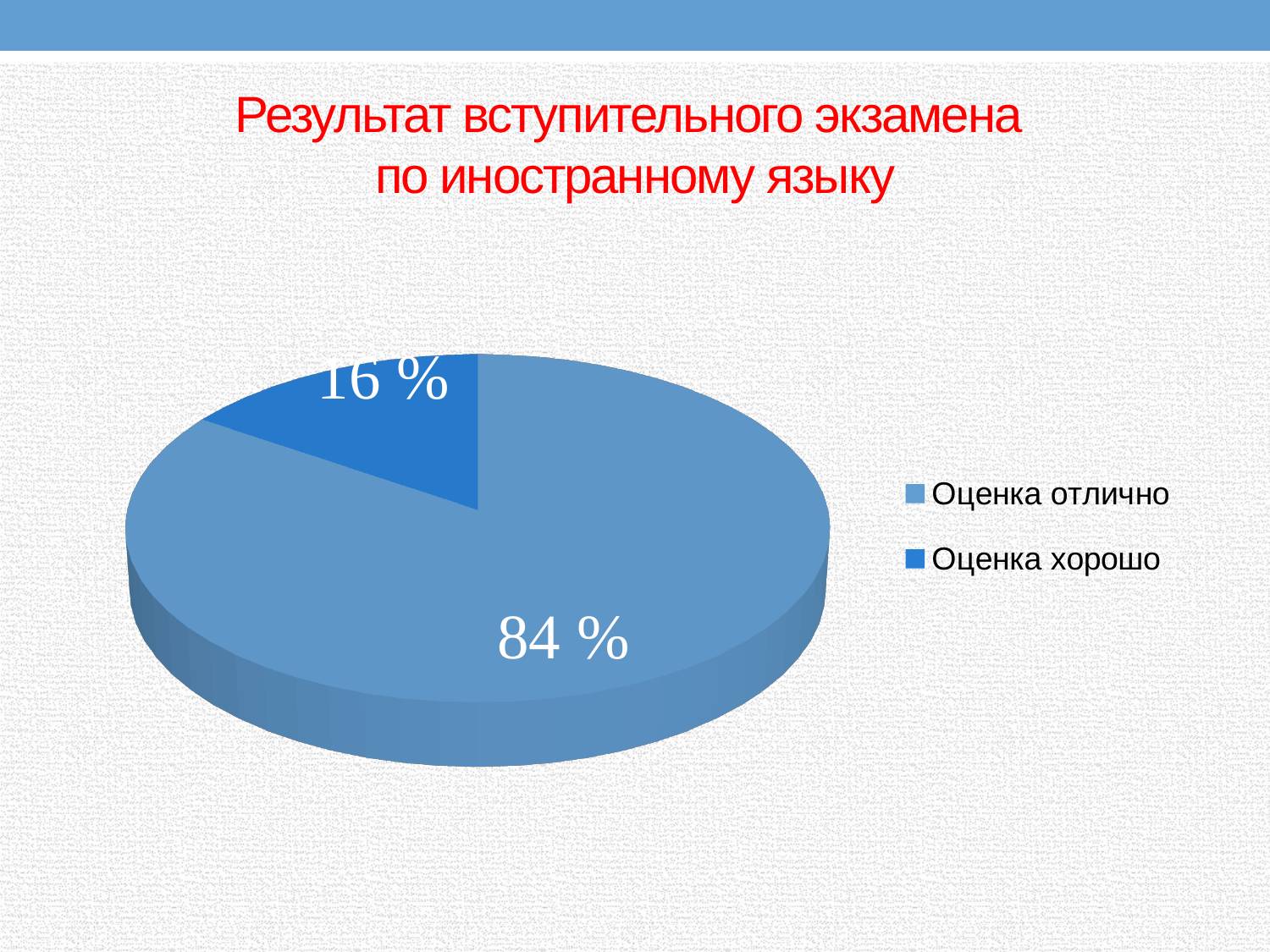
How many entries does the legend list? 2 How many categories does the pie chart have? 2 What share of the pie does "Оценка хорошо" have? 16 % What is the title of the slide containing the chart? Результат вступительного экзамена по иностранному языку Which category has the smallest slice of the pie? Оценка хорошо What type of chart is shown on the slide? pie chart What is the difference in percentage points between "Оценка отлично" and "Оценка хорошо"? 68 Which is larger, the slice for "Оценка отлично" or the slice for "Оценка хорошо"? Оценка отлично Which category has the largest slice of the pie? Оценка отлично What share of the pie does "Оценка отлично" have? 84 % Which category is shown in the darker blue colour? Оценка хорошо